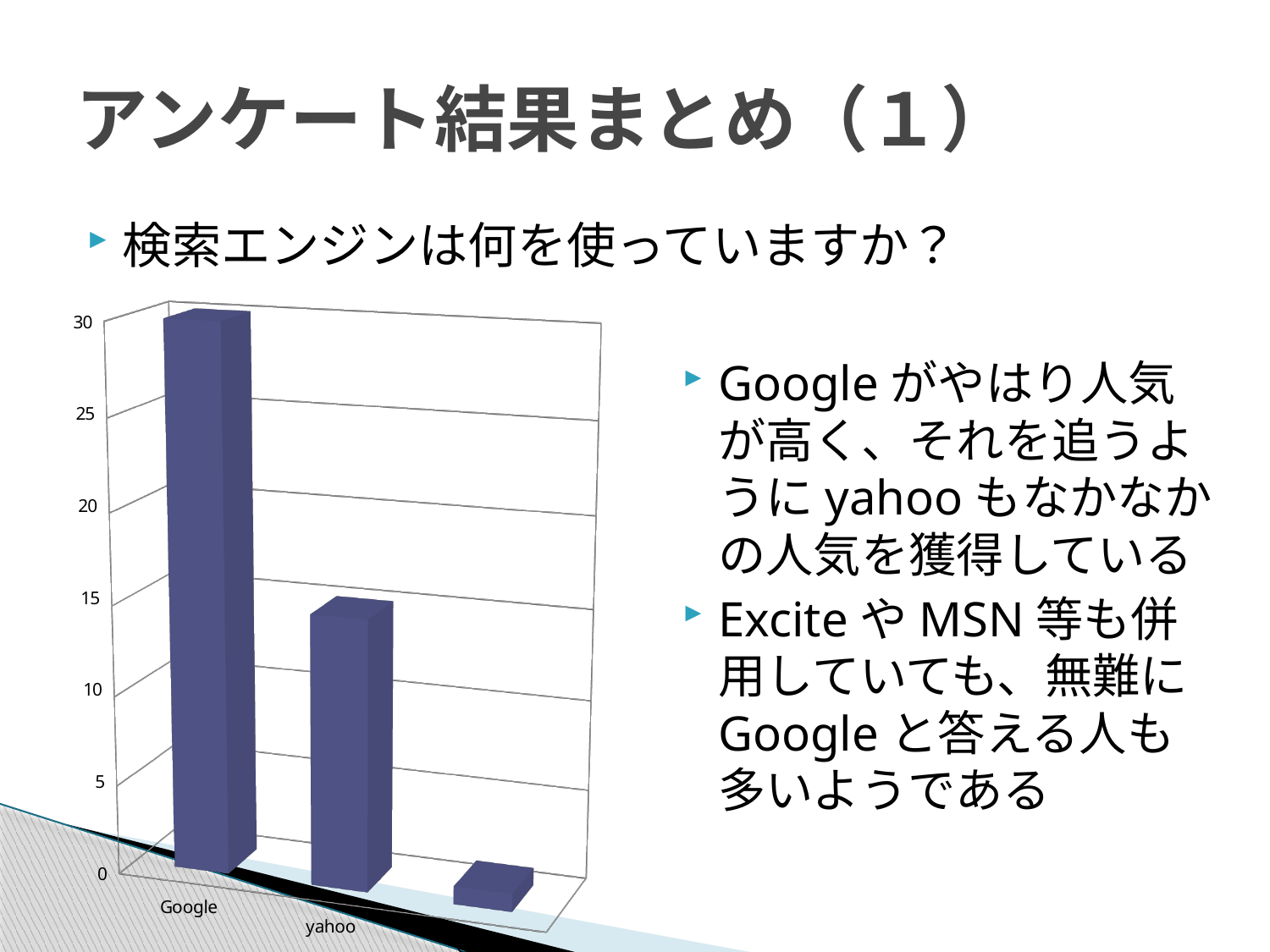
Is the value for Google greater or less than 25? greater How many bars are plotted in the chart? 3 What is the highest tick value shown on the vertical axis of the chart? 30 Is the value for yahoo greater or less than 10? greater Is the value for Google greater or less than 20? greater Which has a larger value, Google or yahoo? Google Do the bar values rise or fall from left to right along the x axis? fall What kind of chart is shown on the slide? bar chart Which category has the highest bar in the chart? Google What survey question does the chart on the slide summarize? 検索エンジンは何を使っていますか？